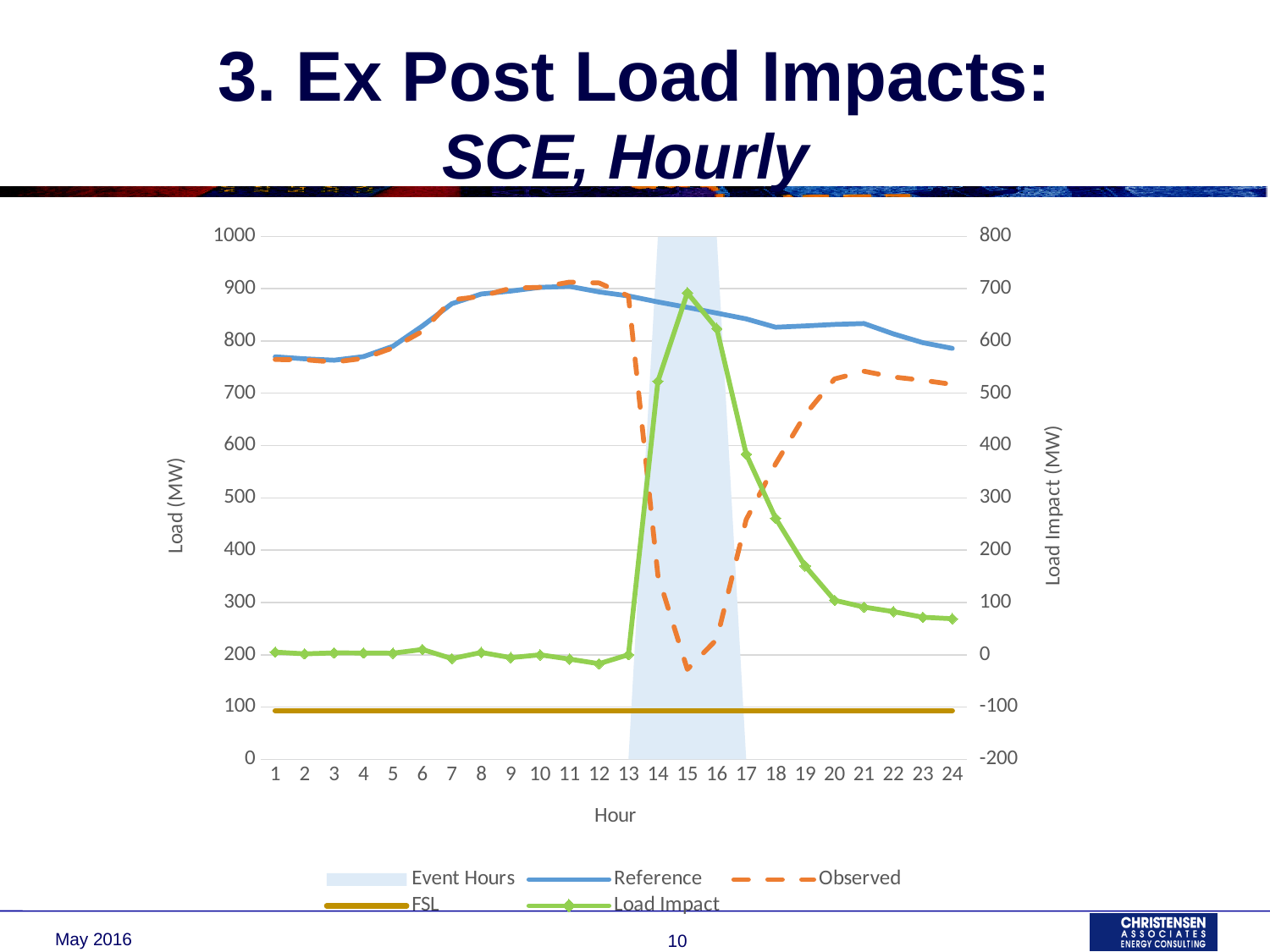
What is the label of the x axis? Hour How many entries does the legend list? 5 At which hour does the Observed series reach its lowest value? 15 Is the Load Impact value at hour 15 greater or less than 600 on the right axis? greater What is the label of the right-hand y axis? Load Impact (MW) Is the Observed value at hour 15 greater or less than 300? less How many hours are plotted along the x axis? 24 At which hour does the Load Impact series reach its highest value? 15 What kind of chart is shown on the slide? line chart Is the Reference value at hour 1 greater or less than 700? greater At hour 15, which is larger, the Reference value or the Observed value? Reference Does the Load Impact series rise or fall from hour 15 to hour 24? fall